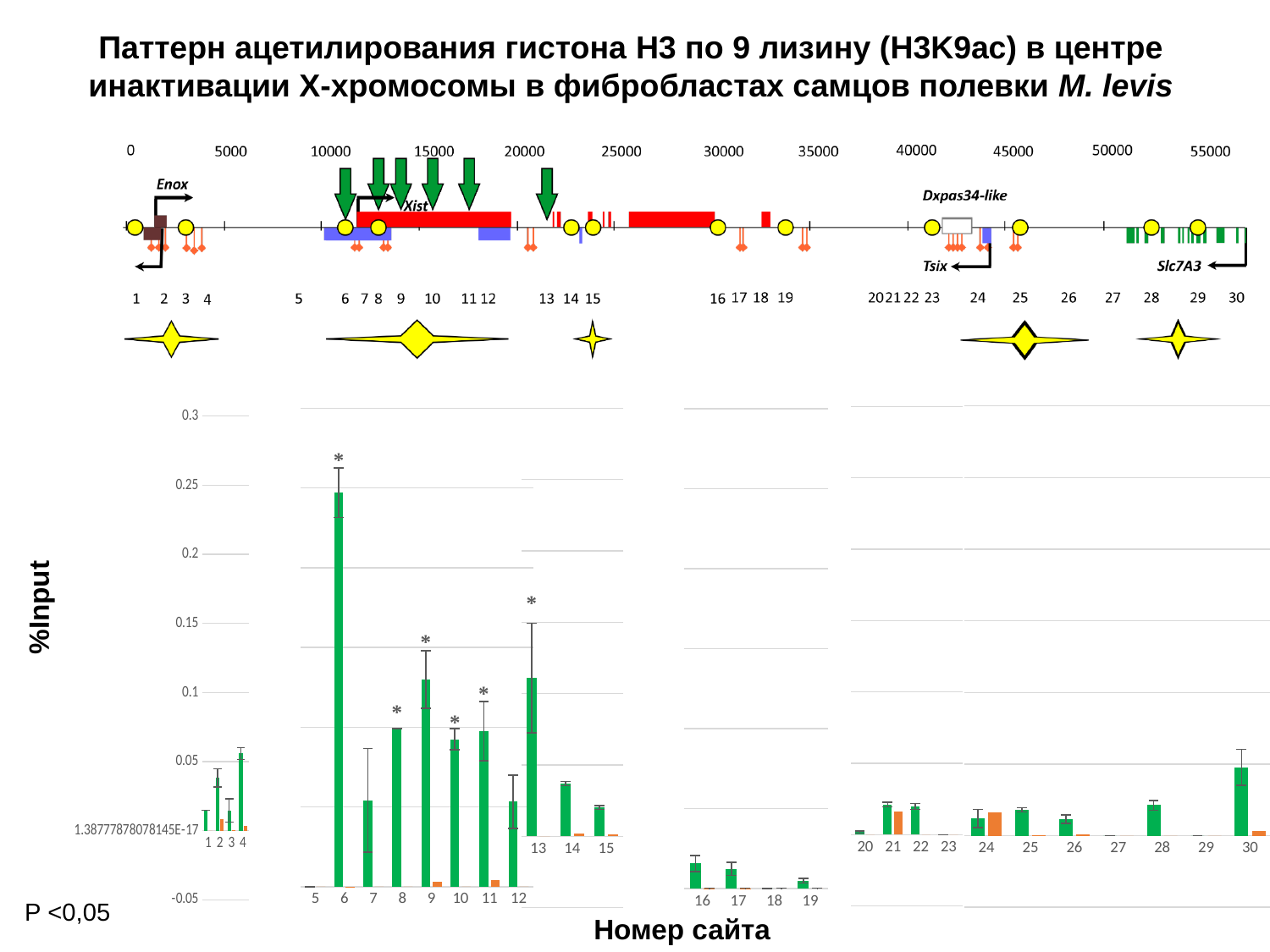
Is the %Input value for site 6 greater or less than 0.2? greater What is the highest value shown on the y axis of the chart? 0.3 What is the label of the y axis of the chart? %Input What kind of chart is shown on the slide? bar chart What is the label of the x axis of the chart? Номер сайта What is the lowest value shown on the y axis of the chart? -0.05 Which has the larger %Input value, site 6 or site 9? site 6 How many site numbers are plotted along the x axis of the chart? 30 Which site number has the highest %Input value in the chart? 6 Which has the larger %Input value, site 9 or site 8? site 9